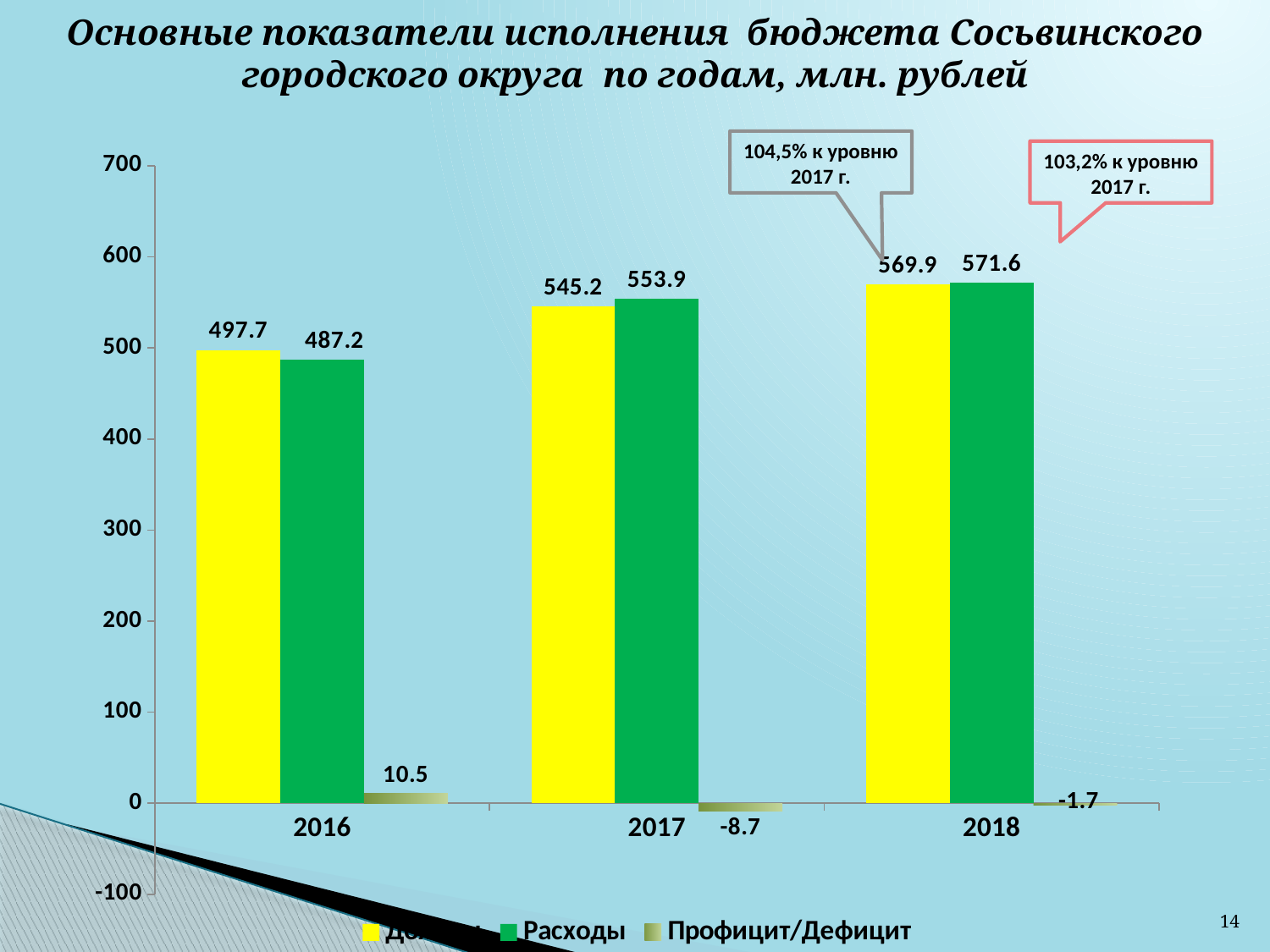
How many years are shown on the x axis? 3 In which year is the yellow series the lowest? 2016 What is the value of Расходы for 2017? 553.9 How many series does the legend list? 3 What is the difference between Расходы in 2018 and Расходы in 2016? 84.4 Do the Расходы values rise or fall from 2016 to 2018? rise What type of chart is shown on the slide? bar chart In which year is Расходы the highest? 2018 Which is larger in 2016: the yellow series or Расходы? the yellow series (497.7) What is the value of the yellow series for 2018? 569.9 What is the value of Профицит/Дефицит for 2017? -8.7 What is the value of Профицит/Дефицит for 2016? 10.5